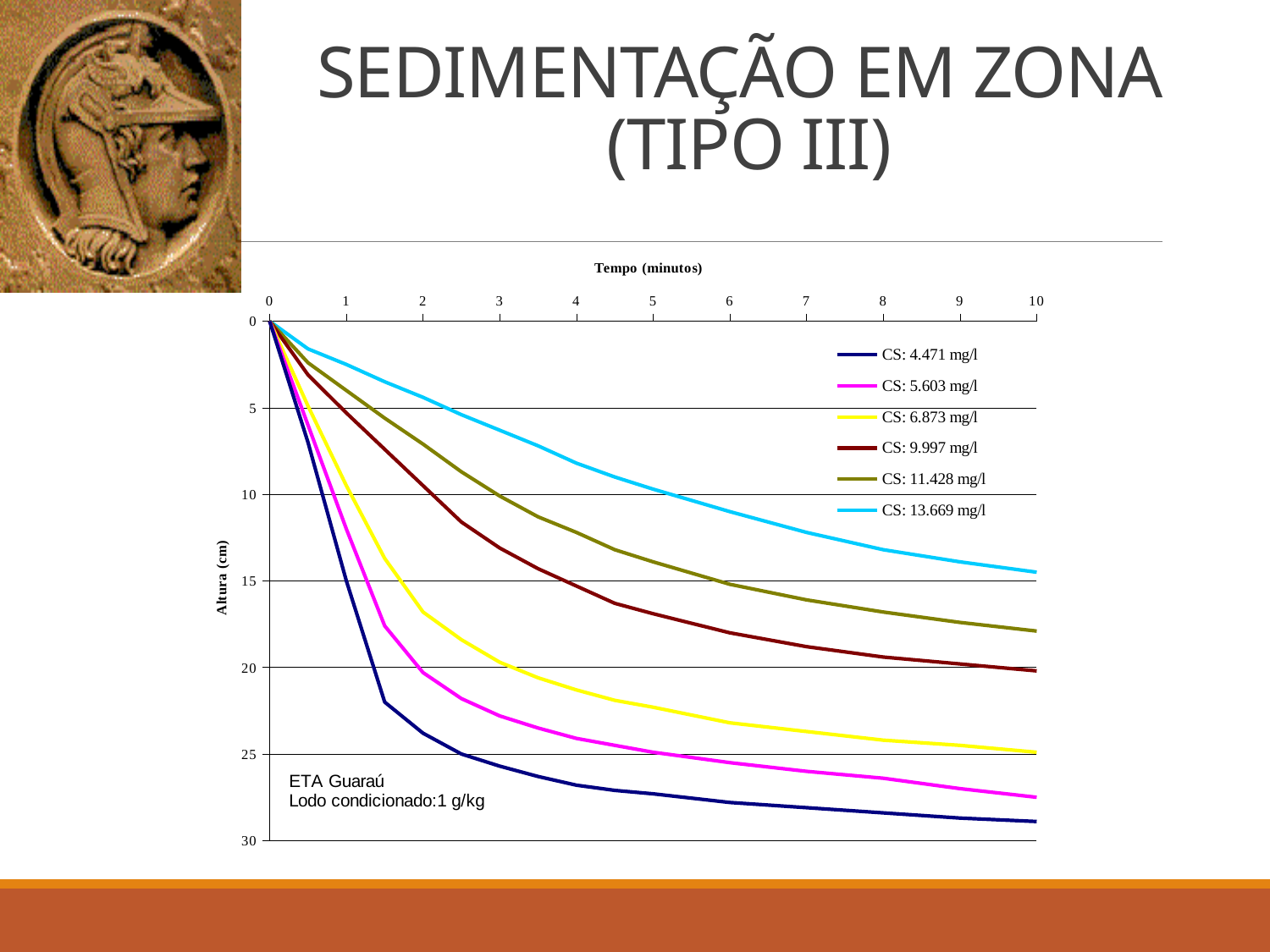
At Tempo 10 minutes, is the Altura value for CS: 4.471 mg/l greater or less than 25? greater At Tempo 5 minutes, which series has the larger Altura (cm) value, CS: 9.997 mg/l or CS: 6.873 mg/l? CS: 6.873 mg/l At Tempo 10 minutes, which series has the smallest Altura (cm) value? CS: 13.669 mg/l At Tempo 2 minutes, is the Altura value for CS: 13.669 mg/l greater or less than 5? less What is the title of the vertical axis of the chart? Altura (cm) What is the title of the horizontal axis of the chart? Tempo (minutos) At Tempo 10 minutes, is the Altura value for CS: 11.428 mg/l greater or less than 20? less How many series does the chart legend list? 6 What kind of chart is shown on the slide? line chart At Tempo 10 minutes, which series has the largest Altura (cm) value? CS: 4.471 mg/l